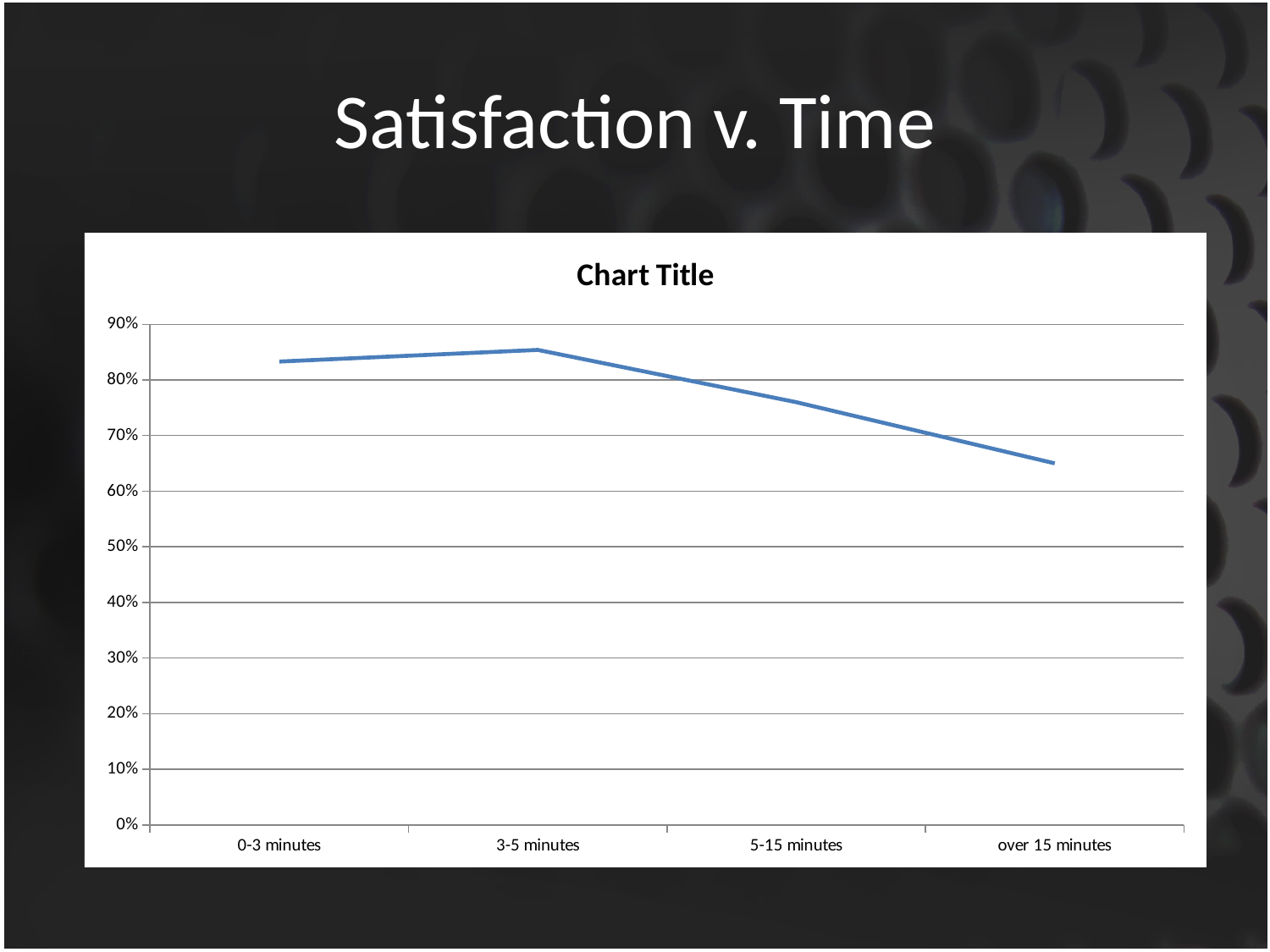
How many time categories are plotted along the x axis? 4 Which time category has the lowest value? over 15 minutes Is the value for 5-15 minutes greater or less than 80%? less Is the value for over 15 minutes greater or less than 70%? less Which is larger, the value for 3-5 minutes or the value for 5-15 minutes? 3-5 minutes What kind of chart is shown on the slide? Line chart Is the value for 5-15 minutes greater or less than 70%? greater Does the line rise or fall from 3-5 minutes to over 15 minutes? Fall Which is larger, the value for 5-15 minutes or the value for over 15 minutes? 5-15 minutes What is the title printed above the chart area? Chart Title